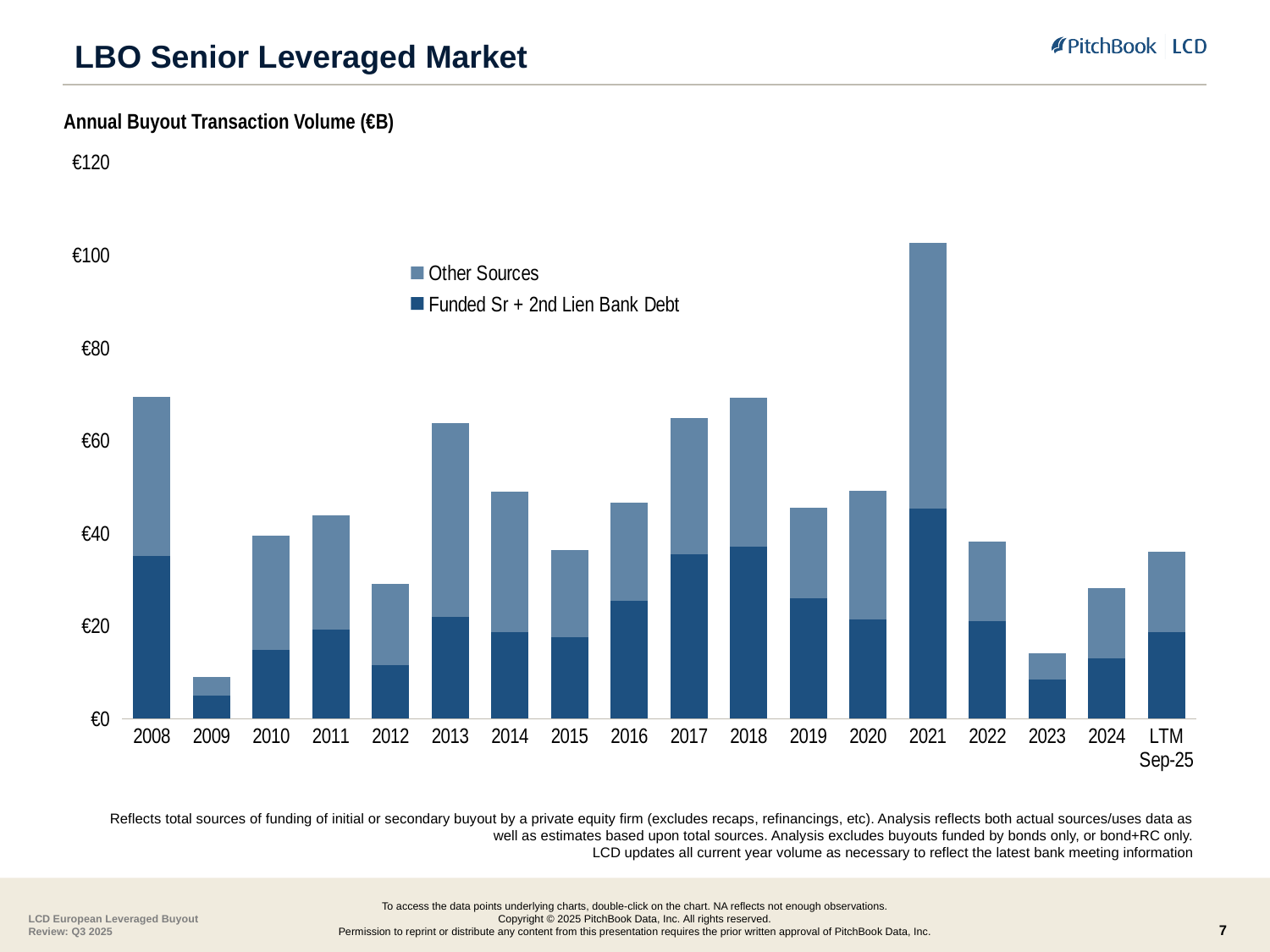
Is the total value for 2009 greater or less than €20? less What kind of chart is shown on the slide? Stacked bar chart Which year has the lowest total annual buyout transaction volume? 2009 How many series does the legend list? 2 What are the two series named in the legend? Other Sources; Funded Sr + 2nd Lien Bank Debt Do the total values rise or fall from 2021 to 2023? fall Which year has the highest total annual buyout transaction volume? 2021 How many categories are shown along the x axis? 18 Which has the larger total volume, 2017 or 2022? 2017 Is the total value for 2021 greater or less than €80? greater Is the total value for 2023 greater or less than €20? less